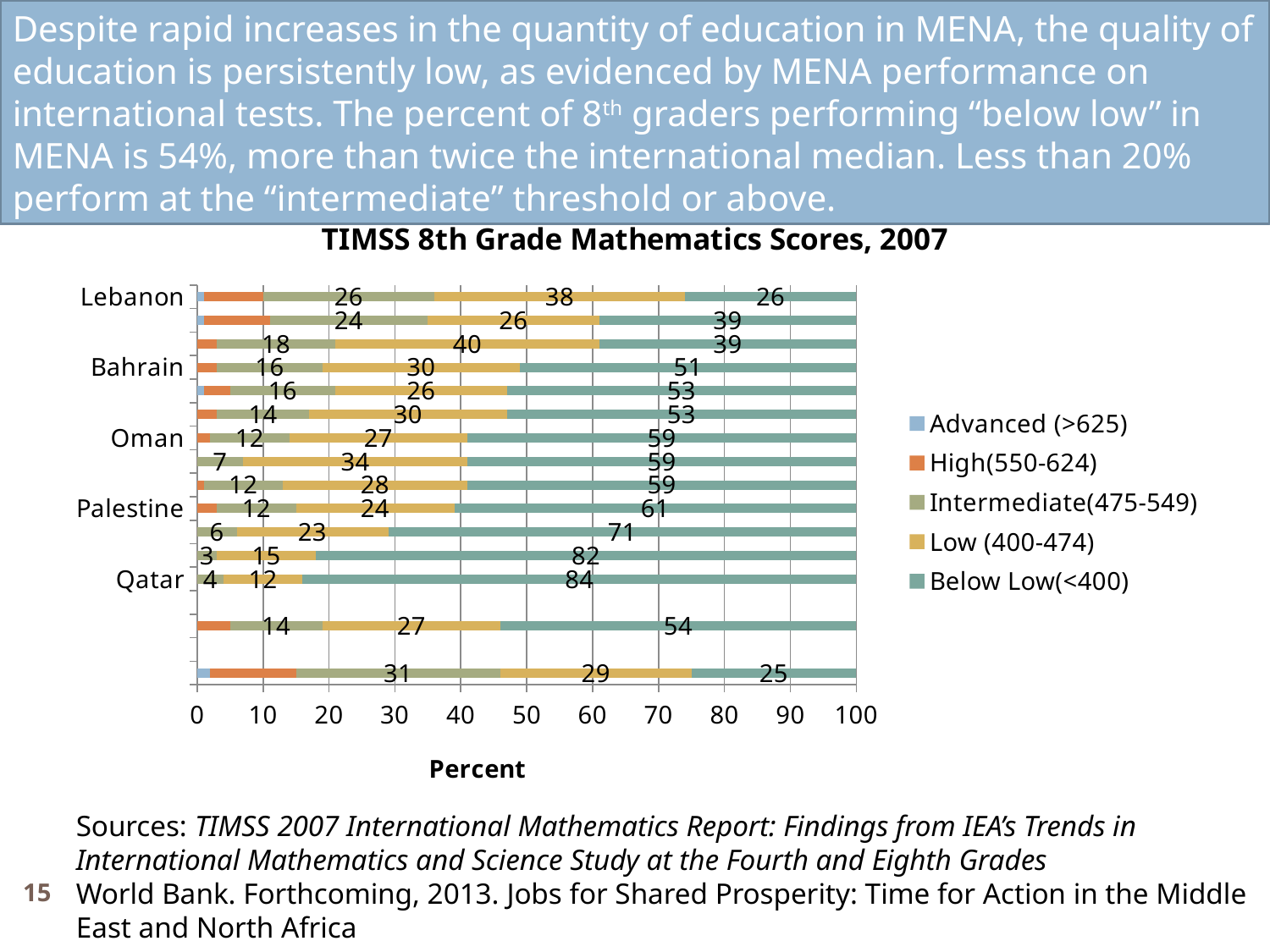
What is the Intermediate(475-549) value for Bahrain? 16 Among Lebanon, Bahrain, Oman, Palestine and Qatar, which has the highest Below Low(<400) value? Qatar What kind of chart is shown on the slide? bar chart What is the label on the horizontal axis of the chart? Percent What is the Below Low(<400) value for Qatar? 84 What is the Low (400-474) value for Palestine? 24 Which has the larger Below Low(<400) value, Lebanon or Qatar? Qatar How many series does the legend list? 5 What is the difference between the Below Low(<400) values for Palestine and Oman? 2 What is the Low (400-474) value for Lebanon? 38 What is the Below Low(<400) value for Oman? 59 What is the title of the chart? TIMSS 8th Grade Mathematics Scores, 2007